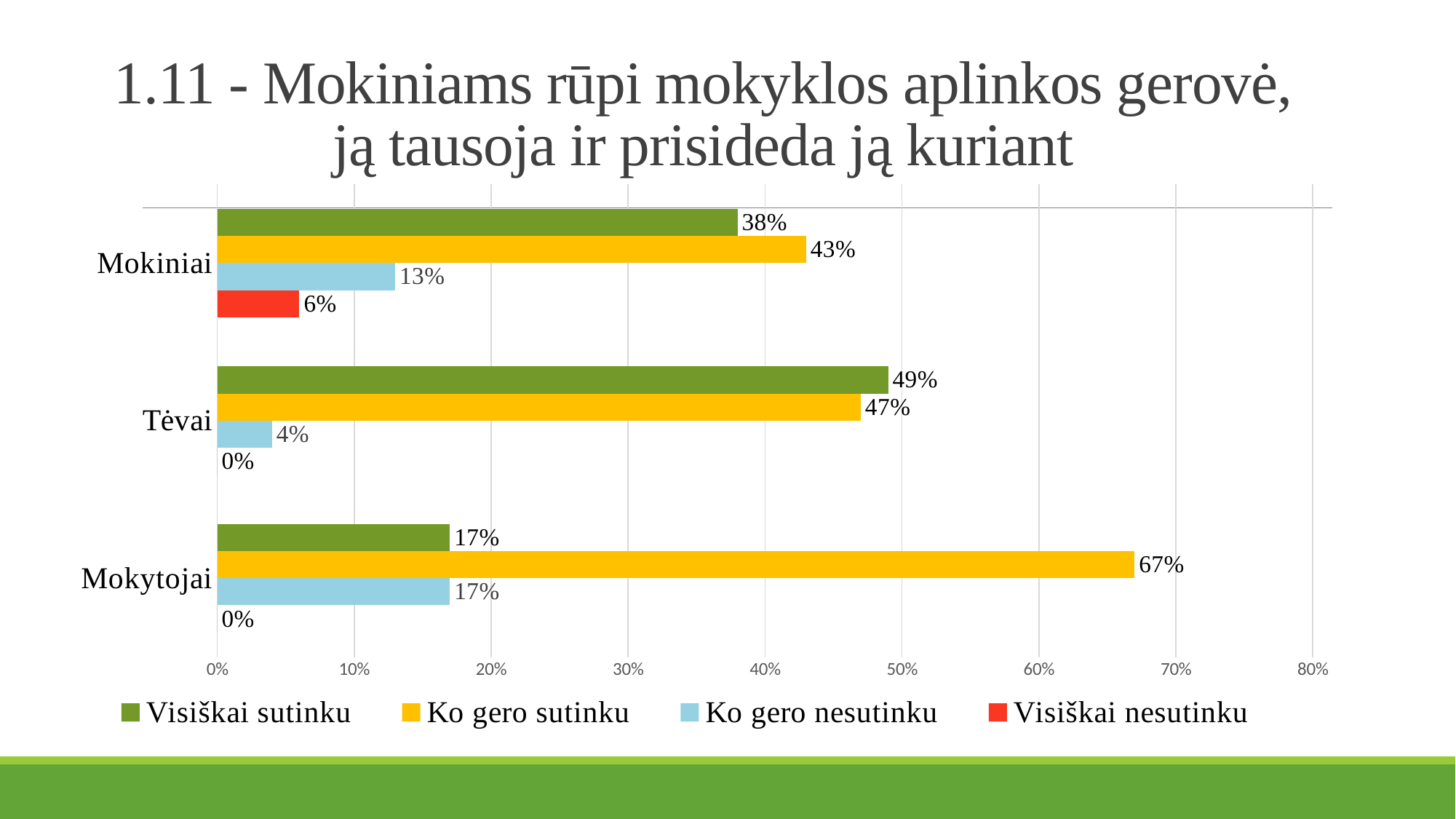
What is the value of "Visiškai sutinku" for Tėvai? 49% Which is larger for Mokiniai: "Visiškai sutinku" or "Ko gero sutinku"? Ko gero sutinku Which category has the lowest value for "Visiškai sutinku"? Mokytojai What kind of chart is shown on the slide? Bar chart How many categories are shown on the vertical axis? 3 Which category has the highest value for "Ko gero sutinku"? Mokytojai What is the value of "Ko gero nesutinku" for Mokiniai? 13% What is the value of "Visiškai nesutinku" for Mokiniai? 6% What is the value of "Ko gero sutinku" for Mokytojai? 67% What is the difference between "Ko gero sutinku" and "Visiškai sutinku" for Mokytojai? 50% Which colour represents "Visiškai nesutinku" in the legend? Red How many series does the legend list? 4